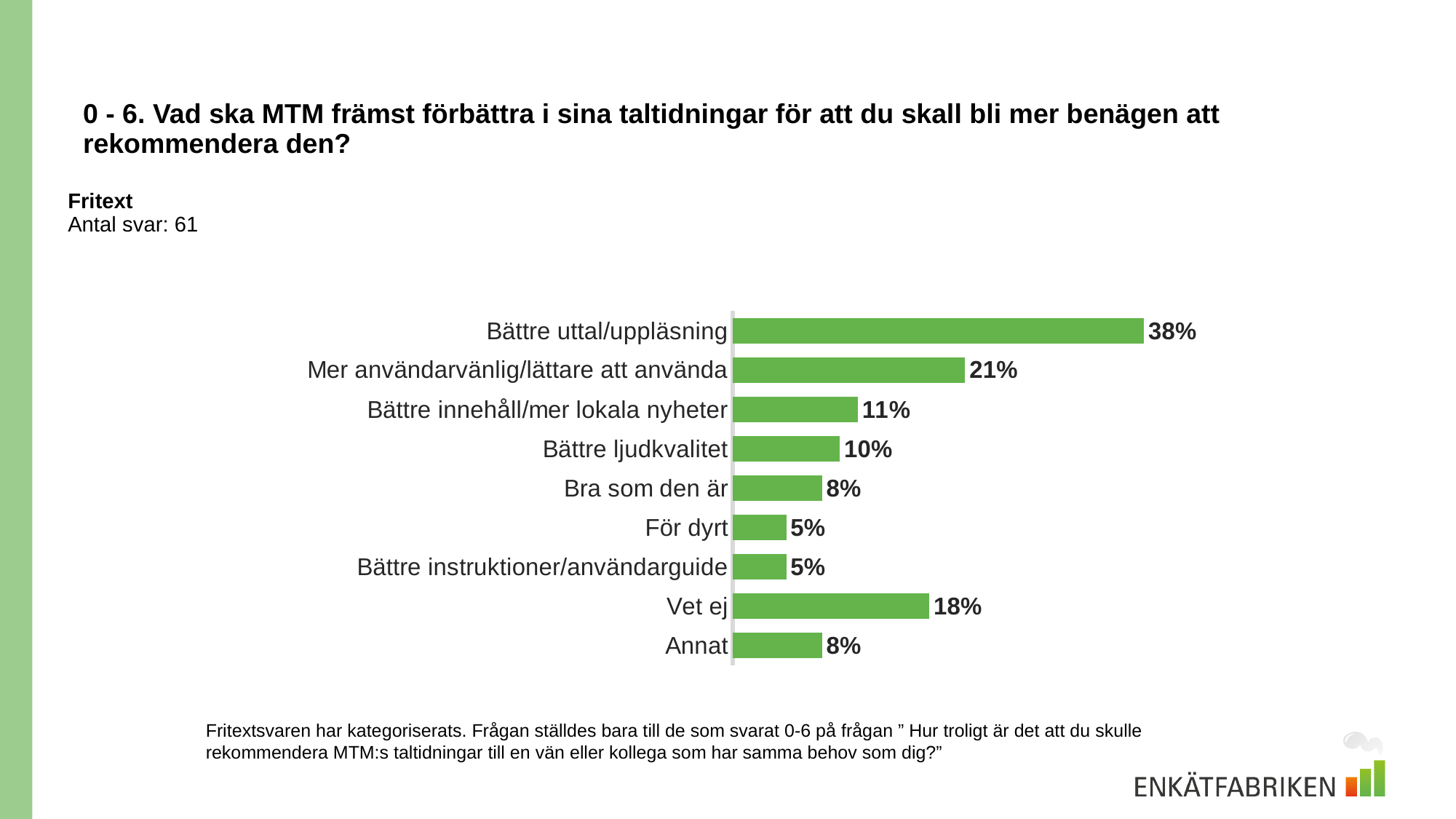
What kind of chart is shown on the slide? Bar chart Which is larger, "Bra som den är" or "För dyrt"? Bra som den är How many categories are shown in the chart? 9 What is the difference between "Bättre uttal/uppläsning" and "Mer användarvänlig/lättare att använda"? 17% Which is larger, "Bättre innehåll/mer lokala nyheter" or "Vet ej"? Vet ej What is the value for "Vet ej"? 18% What is the value for "Bättre uttal/uppläsning"? 38% Which category has the highest value? Bättre uttal/uppläsning What is the value for "Bättre ljudkvalitet"? 10% How many responses (Antal svar) does the slide report? 61 What is the value for "Mer användarvänlig/lättare att använda"? 21% What is the difference between "Vet ej" and "Annat"? 10%